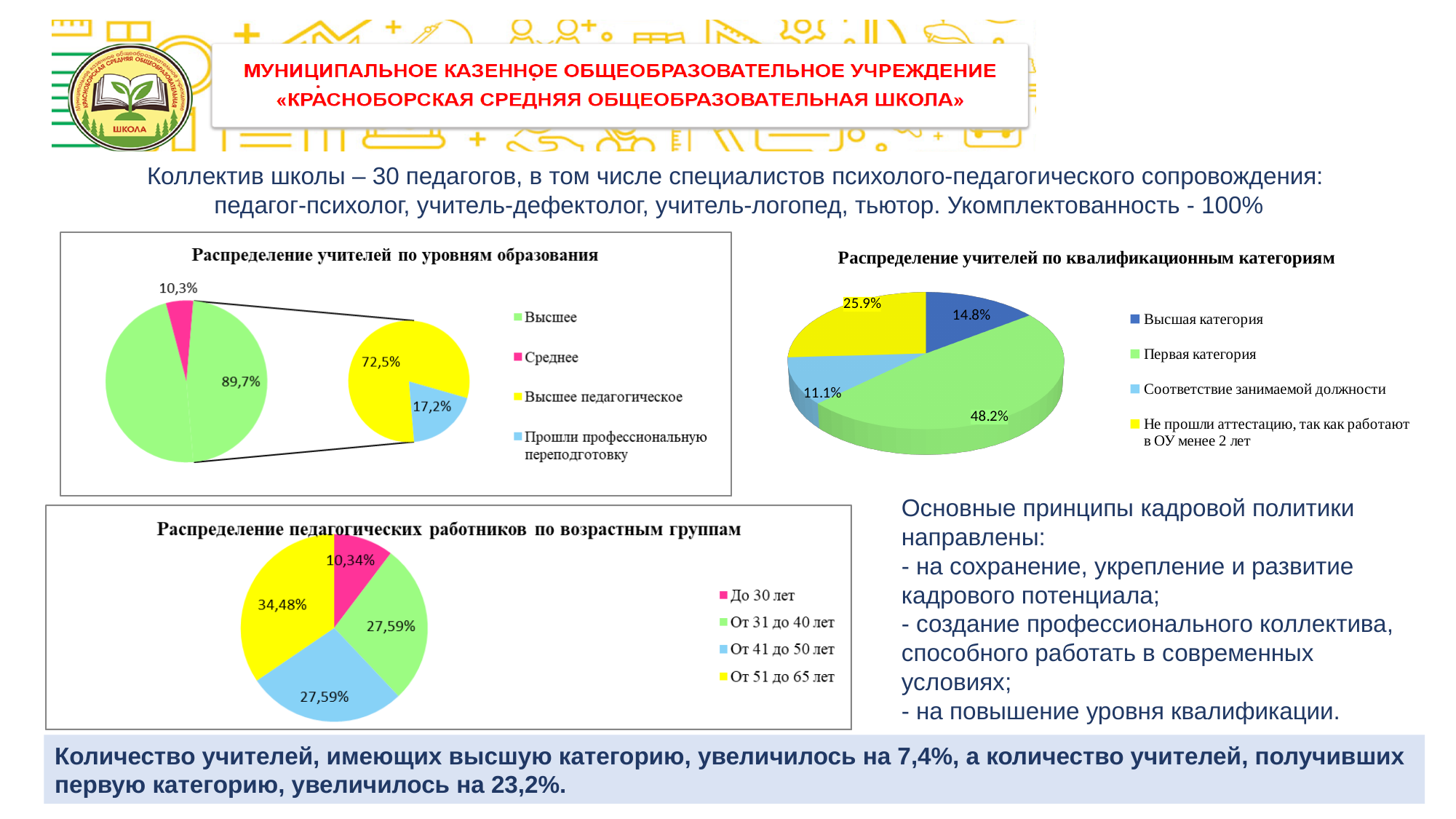
На диаграмме «Распределение учителей по квалификационным категориям» какая категория имеет наименьшую долю? Соответствие занимаемой должности Какого типа диаграмма «Распределение педагогических работников по возрастным группам»? Круговая диаграмма На диаграмме «Распределение педагогических работников по возрастным группам» какая возрастная группа имеет наибольшую долю? От 51 до 65 лет Сколько возрастных групп показано на диаграмме «Распределение педагогических работников по возрастным группам»? 4 На диаграмме «Распределение учителей по уровням образования» сколько элементов перечислено в легенде? 4 На диаграмме «Распределение учителей по квалификационным категориям» какая доля учителей имеет высшую категорию? 14.8% На диаграмме «Распределение учителей по уровням образования» какая доля учителей прошла профессиональную переподготовку? 17,2% На диаграмме «Распределение учителей по уровням образования» какая доля учителей имеет высшее образование? 89,7% На диаграмме «Распределение педагогических работников по возрастным группам» какая доля работников в возрасте до 30 лет? 10,34% На диаграмме «Распределение учителей по квалификационным категориям» на сколько процентных пунктов доля первой категории больше доли высшей категории? 33.4 На диаграмме «Распределение педагогических работников по возрастным группам» что больше: доля группы «От 51 до 65 лет» или доля группы «От 41 до 50 лет»? От 51 до 65 лет На диаграмме «Распределение учителей по квалификационным категориям» какая доля учителей имеет первую категорию? 48.2%